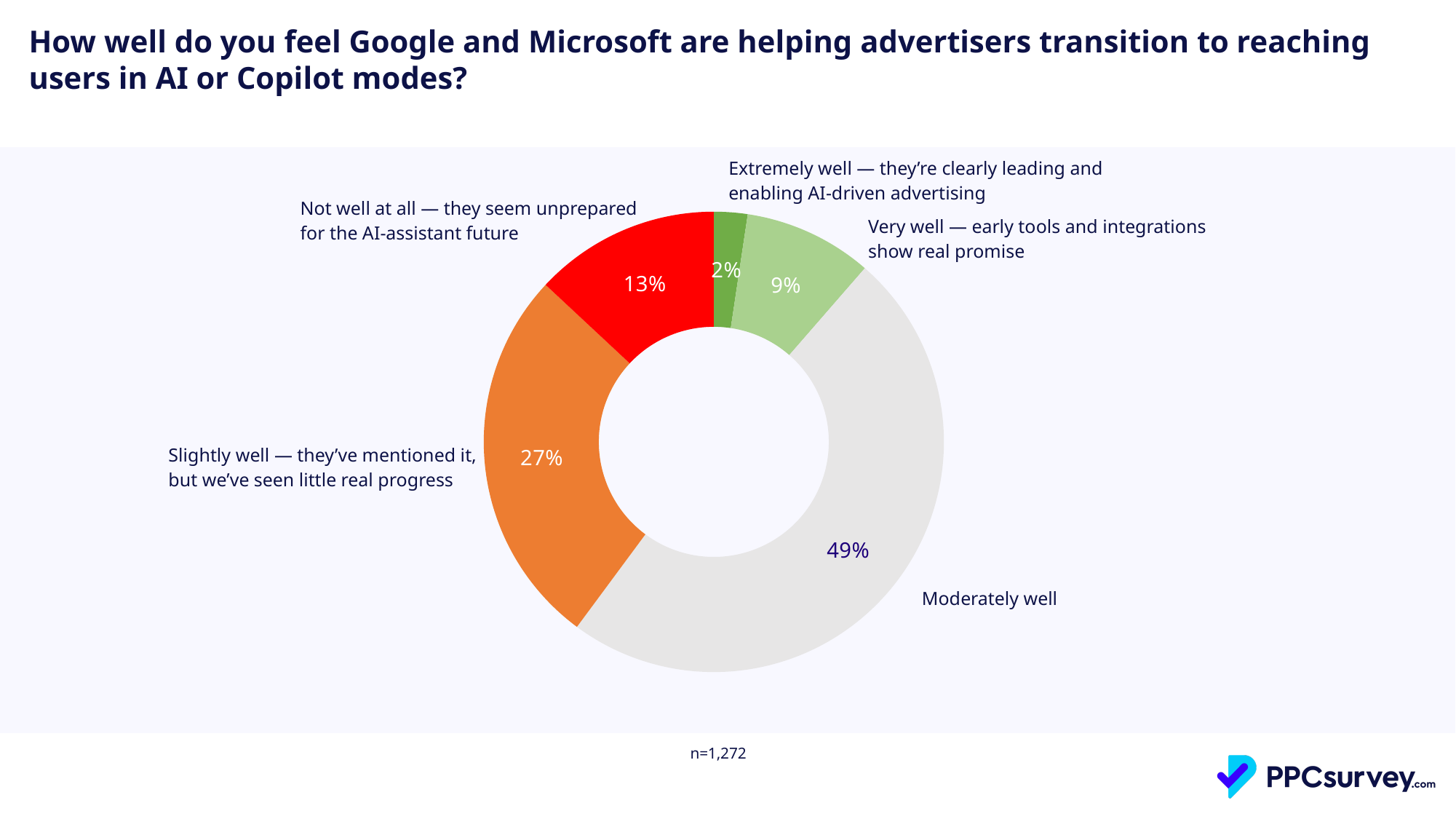
What type of chart is shown on the slide? Donut (pie) chart Which response option has the largest share of the pie? Moderately well What percentage selected "Not well at all — they seem unprepared for the AI-assistant future"? 13% What share of respondents chose "Slightly well — they've mentioned it, but we've seen little real progress"? 27% What percentage of respondents said "Extremely well — they're clearly leading and enabling AI-driven advertising"? 2% Which is larger: the share for "Very well" or the share for "Not well at all"? Not well at all What is the combined share of "Extremely well" and "Very well" responses? 11% What is the difference in percentage points between "Slightly well" and "Not well at all"? 14 percentage points How many response categories are shown in the chart? 5 What is the sample size (n) shown on the slide? n=1,272 Which response option has the smallest share? Extremely well — they're clearly leading and enabling AI-driven advertising What percentage of respondents answered "Moderately well"? 49%